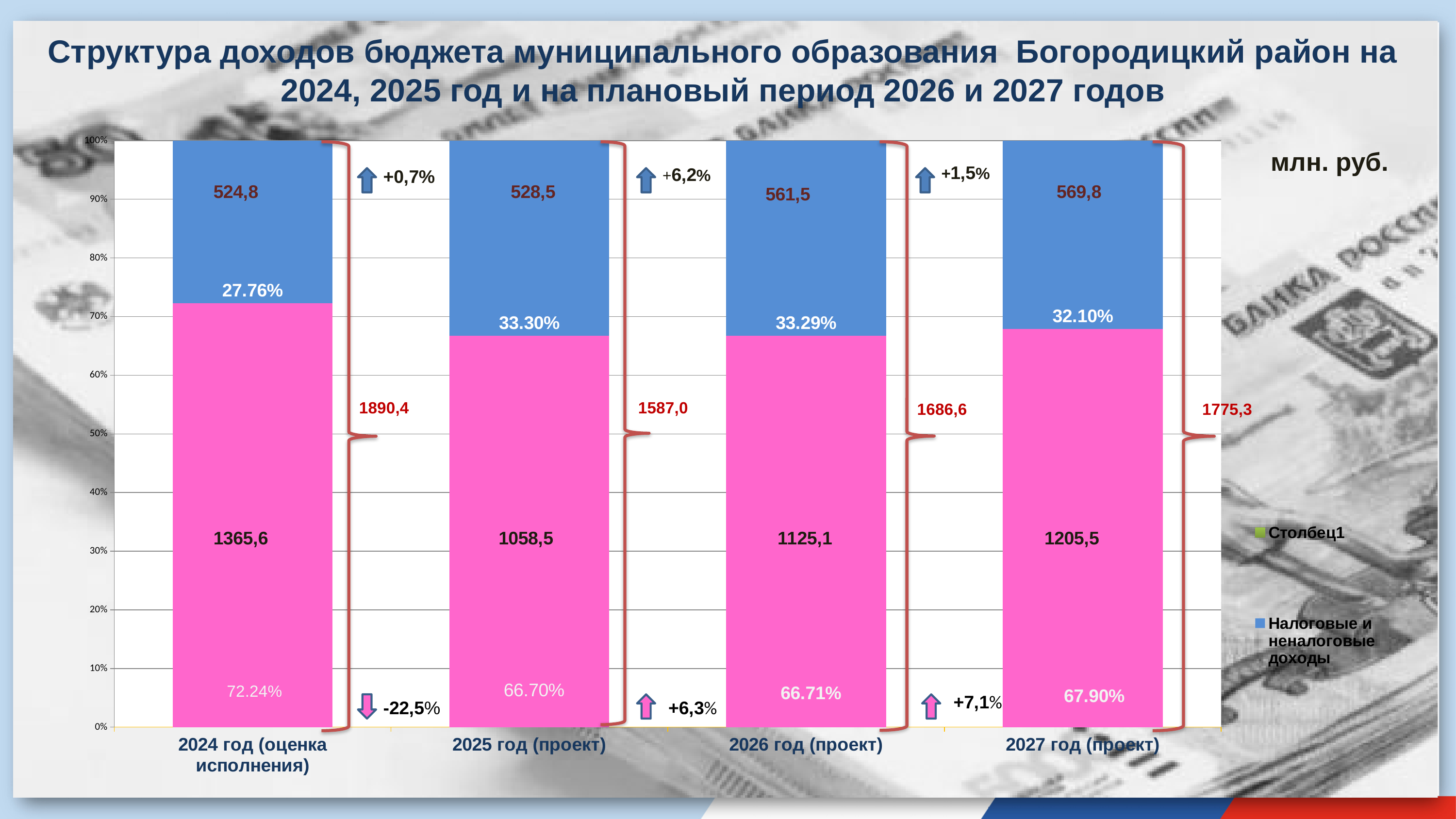
What type of chart is shown on the slide? Stacked bar chart What unit of measurement is indicated in the top right corner of the chart? млн. руб. What is the total shown for the '2026 год (проект)' bar? 1686,6 How many year categories are shown on the x axis of the chart? 4 How many entries does the chart legend list? 2 What is the value of the pink segment for '2025 год (проект)'? 1058,5 In which year is the value of 'Налоговые и неналоговые доходы' (blue segment) the highest? 2027 год (проект) What is the value of 'Налоговые и неналоговые доходы' (blue segment) for '2024 год (оценка исполнения)'? 524,8 In which year is the pink segment value the lowest? 2025 год (проект) What percentage share does the blue segment 'Налоговые и неналоговые доходы' have in '2027 год (проект)'? 32.10% Which bar has the larger total: '2024 год (оценка исполнения)' or '2025 год (проект)'? 2024 год (оценка исполнения) What is the difference between the 'Налоговые и неналоговые доходы' values for '2027 год (проект)' and '2026 год (проект)'? 8,3